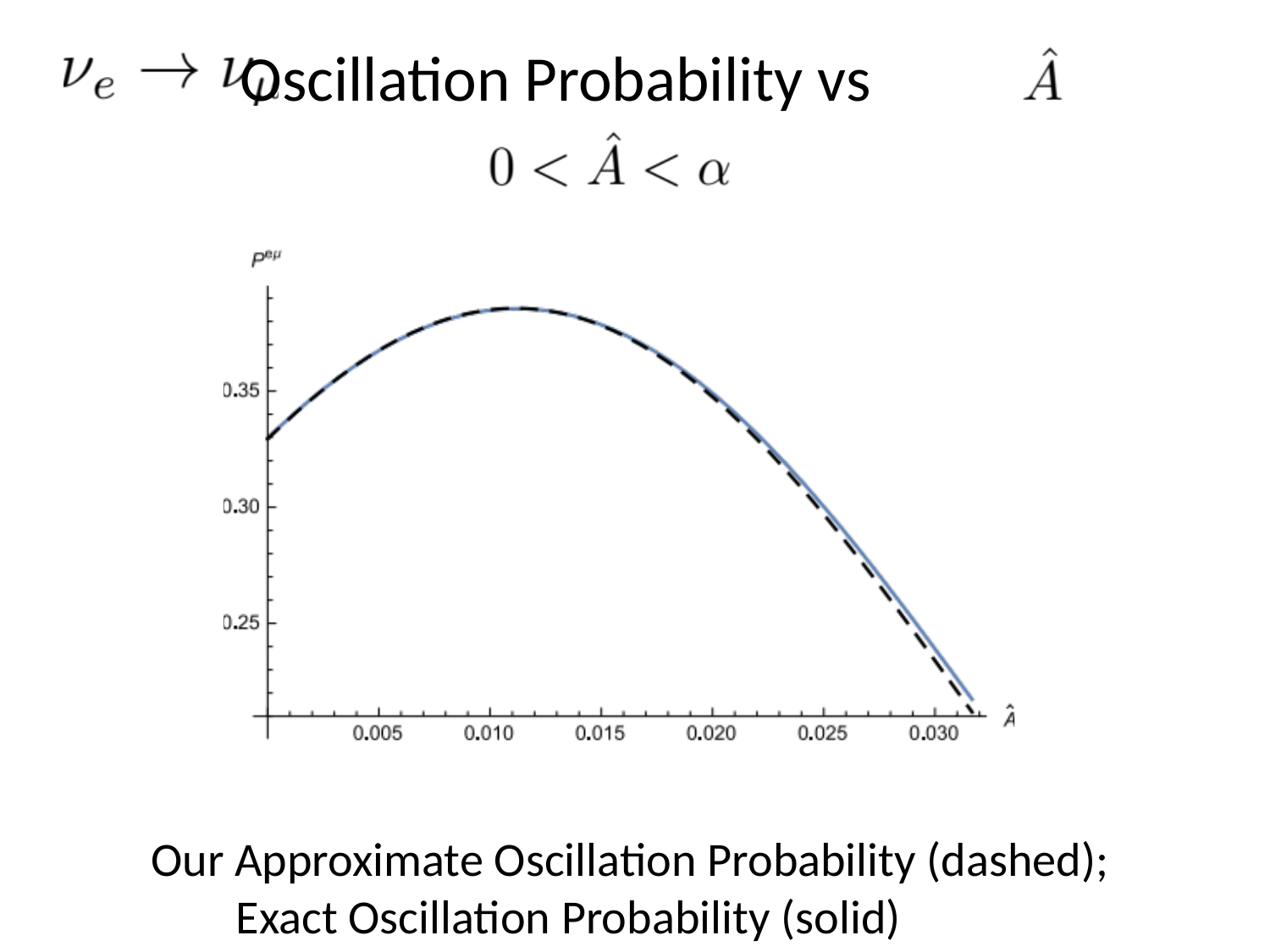
How does the oscillation probability change as Â increases from 0.015 to 0.030? it falls Is the value of the curve at Â = 0.005 greater or less than 0.35? greater How many curves are plotted on the chart? 2 How does the oscillation probability change as Â increases from 0 to 0.010? it rises What is the largest tick value labelled on the x axis? 0.030 According to the caption, which curve style represents the approximate oscillation probability? dashed Is the value of the curve at Â = 0.030 greater or less than 0.25? less Near Â = 0.030, which curve is higher, the solid or the dashed one? solid What kind of chart is shown on the slide? line chart According to the caption, which curve style represents the exact oscillation probability? solid Is the value of the curve at Â = 0.015 greater or less than 0.35? greater